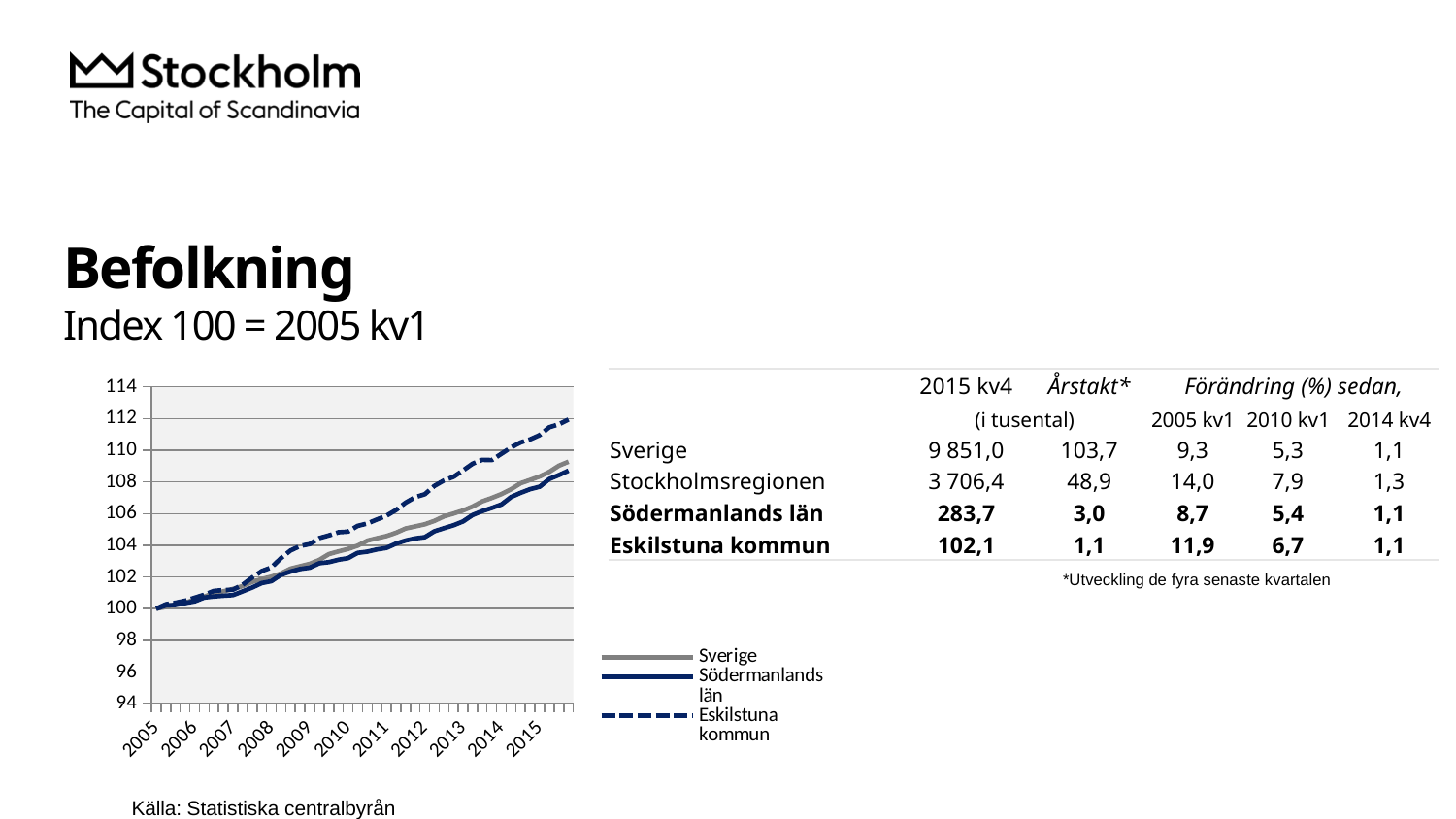
Do the index values in the chart rise or fall from 2005 to 2015? rise What kind of chart is shown on the slide? line chart What is the index value for all three series at the start of 2005 in the chart? 100 Which series is drawn with a grey line in the chart? Sverige How many series does the chart's legend list? 3 Which series is drawn with a dashed line in the chart? Eskilstuna kommun At the end of 2015, which series has the larger index value, Eskilstuna kommun or Sverige? Eskilstuna kommun At the end of 2015, is the index value for Sverige greater or less than 108? greater How many year labels are shown on the x axis of the chart? 11 Which series has the highest index value at the end of 2015 in the chart? Eskilstuna kommun At the end of 2015, is the index value for Södermanlands län greater or less than 106? greater At the end of 2015, is the index value for Eskilstuna kommun greater or less than 110? greater